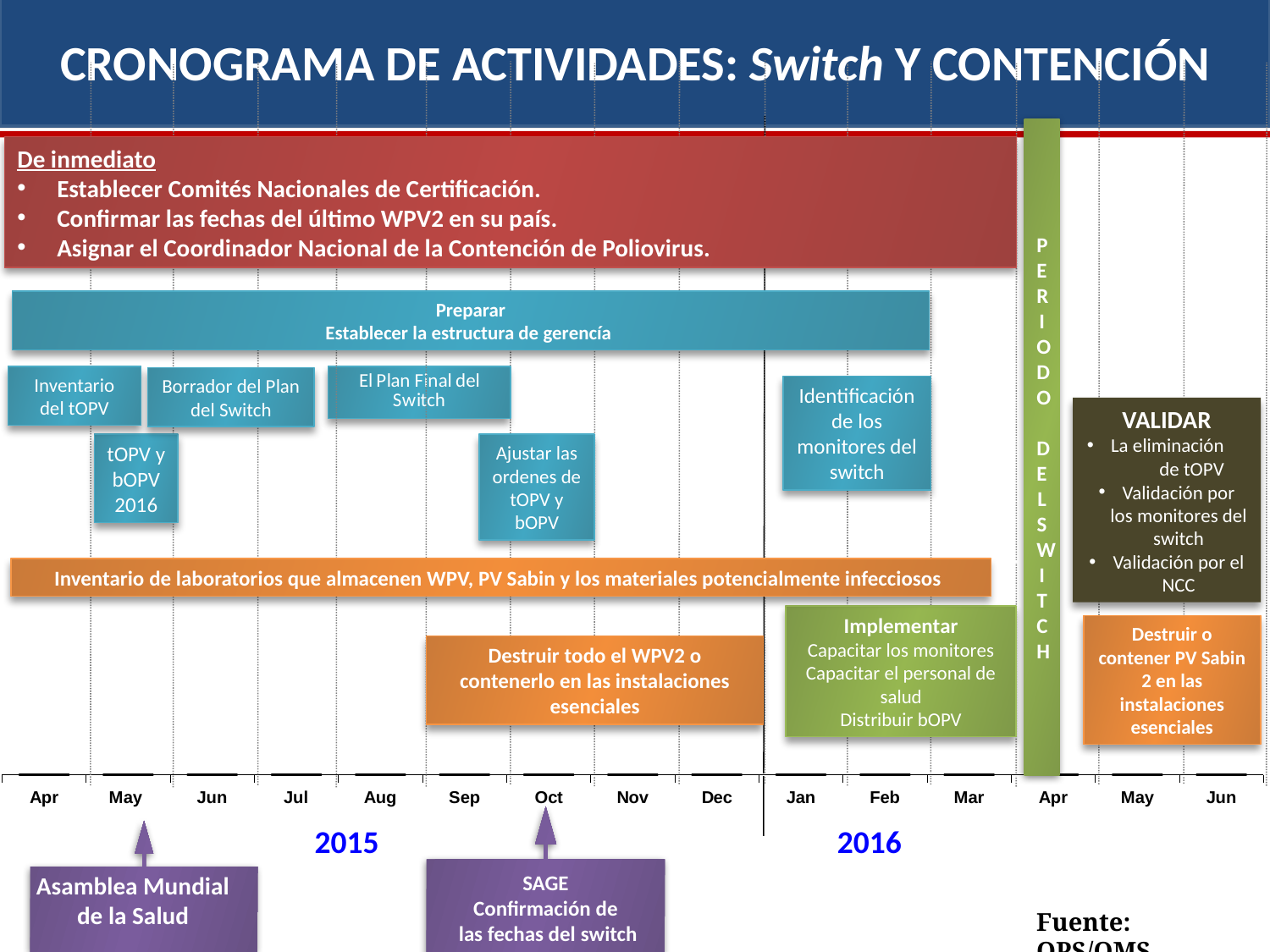
Which event is marked with an arrow at Oct 2015 on the timeline? SAGE Confirmación de las fechas del switch What is the title of the chart on the slide? CRONOGRAMA DE ACTIVIDADES: Switch Y CONTENCIÓN What kind of chart is shown on the slide? Gantt-style timeline chart Which activity on the timeline starts first: 'Inventario del tOPV' or 'El Plan Final del Switch'? Inventario del tOPV What is the source cited for the chart? OPS/OMS Which month does the timeline axis end with? Jun Which month does the timeline axis start with? Apr Which event is marked with an arrow at May 2015 on the timeline? Asamblea Mundial de la Salud Which month on the timeline does the vertical 'PERIODO DEL SWITCH' bar align with? Apr 2016 Which two years are labelled on the timeline axis? 2015 and 2016 How many month labels are shown along the timeline axis? 15